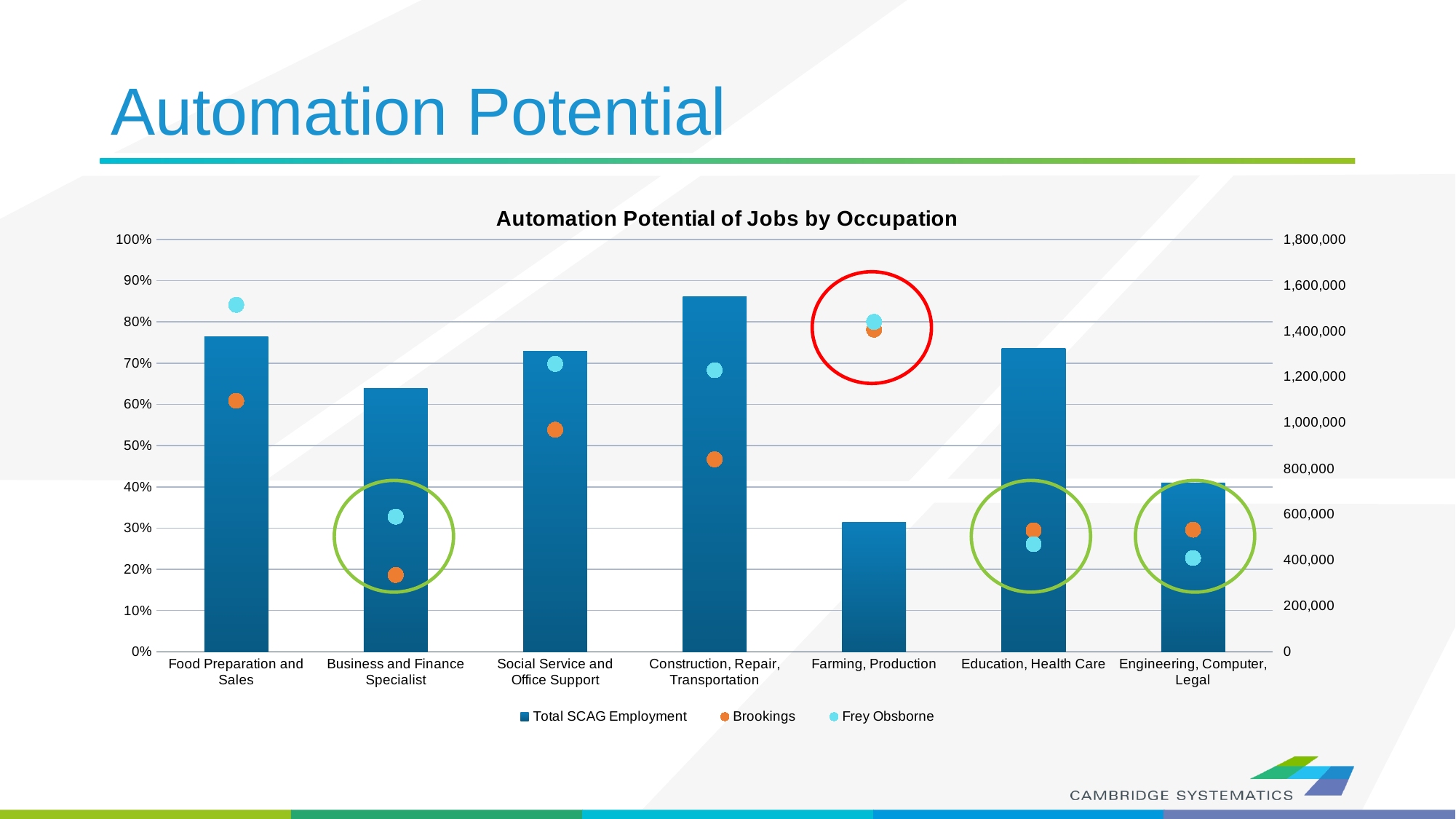
For Food Preparation and Sales, which is larger: the Brookings value or the Frey Obsborne value? Frey Obsborne What kind of chart is shown on the slide? combination bar and line chart (bars with dot markers) Which occupation has the lowest Total SCAG Employment bar? Farming, Production How many occupation categories are shown on the x axis? 7 How many series does the legend list? 3 Which occupation has the highest Total SCAG Employment bar? Construction, Repair, Transportation Which occupation has the highest Brookings automation potential? Farming, Production Is the Total SCAG Employment for Farming, Production greater or less than 800,000? less What is the title of the chart? Automation Potential of Jobs by Occupation Is the Brookings value for Business and Finance Specialist greater or less than 30%? less Is the Frey Obsborne value for Food Preparation and Sales greater or less than 70%? greater Which has the larger Total SCAG Employment bar: Education, Health Care or Engineering, Computer, Legal? Education, Health Care